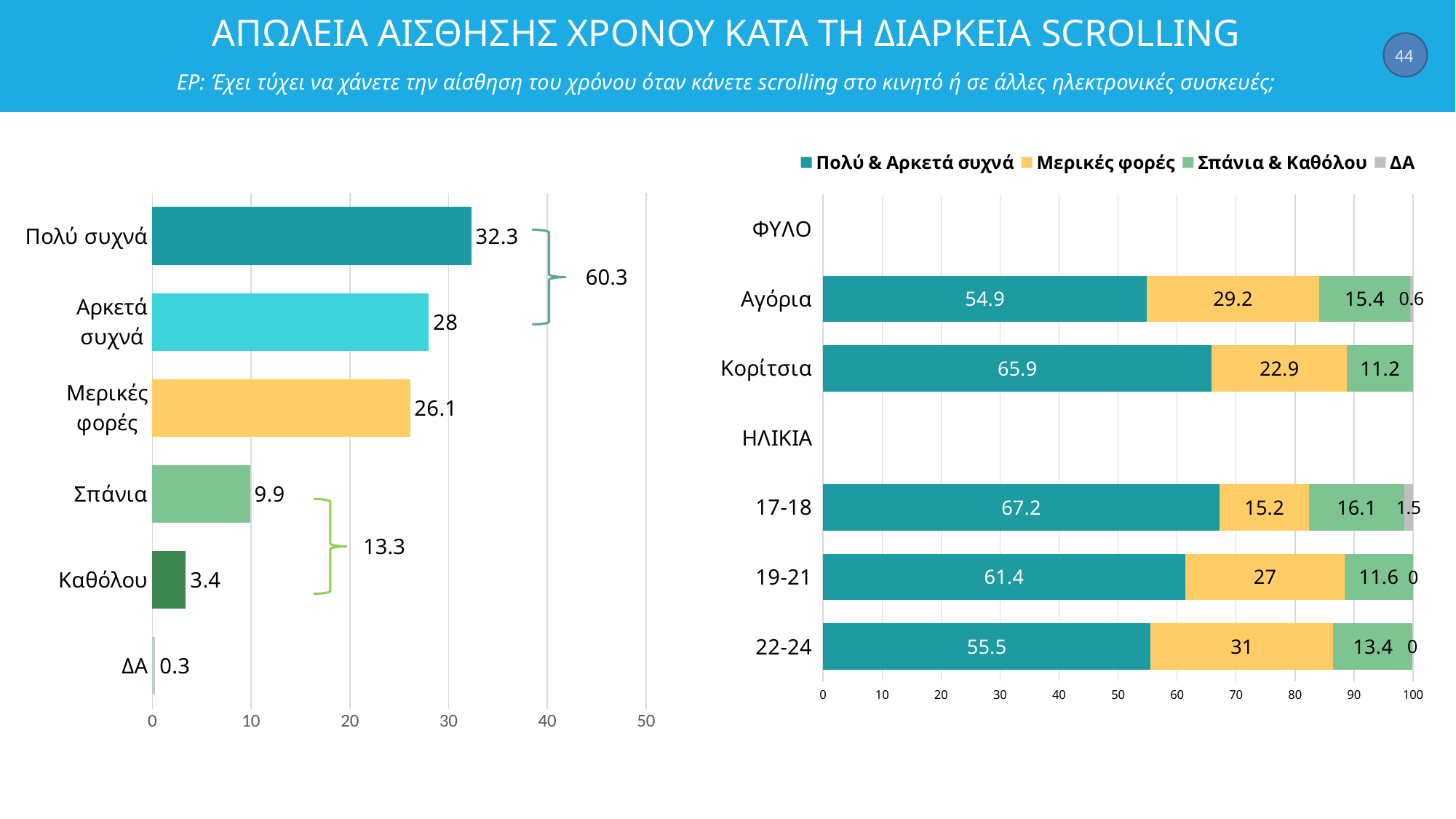
In the right chart, which age group has the highest value for Πολύ & Αρκετά συχνά? 17-18 In the right chart, what is the value of ΔΑ for 17-18? 1.5 What kind of chart is the right chart? stacked bar chart In the right chart, what is the difference between Πολύ & Αρκετά συχνά for Κορίτσια and for Αγόρια? 11 In the left chart, is the value for Μερικές φορές greater or less than 30? less In the right chart, how many series does the legend list? 4 In the right chart, which is larger: Μερικές φορές for Αγόρια or Μερικές φορές for Κορίτσια? Αγόρια In the right chart, what is the value of Πολύ & Αρκετά συχνά for Κορίτσια? 65.9 In the left chart, what is the value for Πολύ συχνά? 32.3 In the left chart, what is the difference between Πολύ συχνά and Αρκετά συχνά? 4.3 In the left chart, which category has the lowest value? ΔΑ In the left chart, how many categories are shown? 6